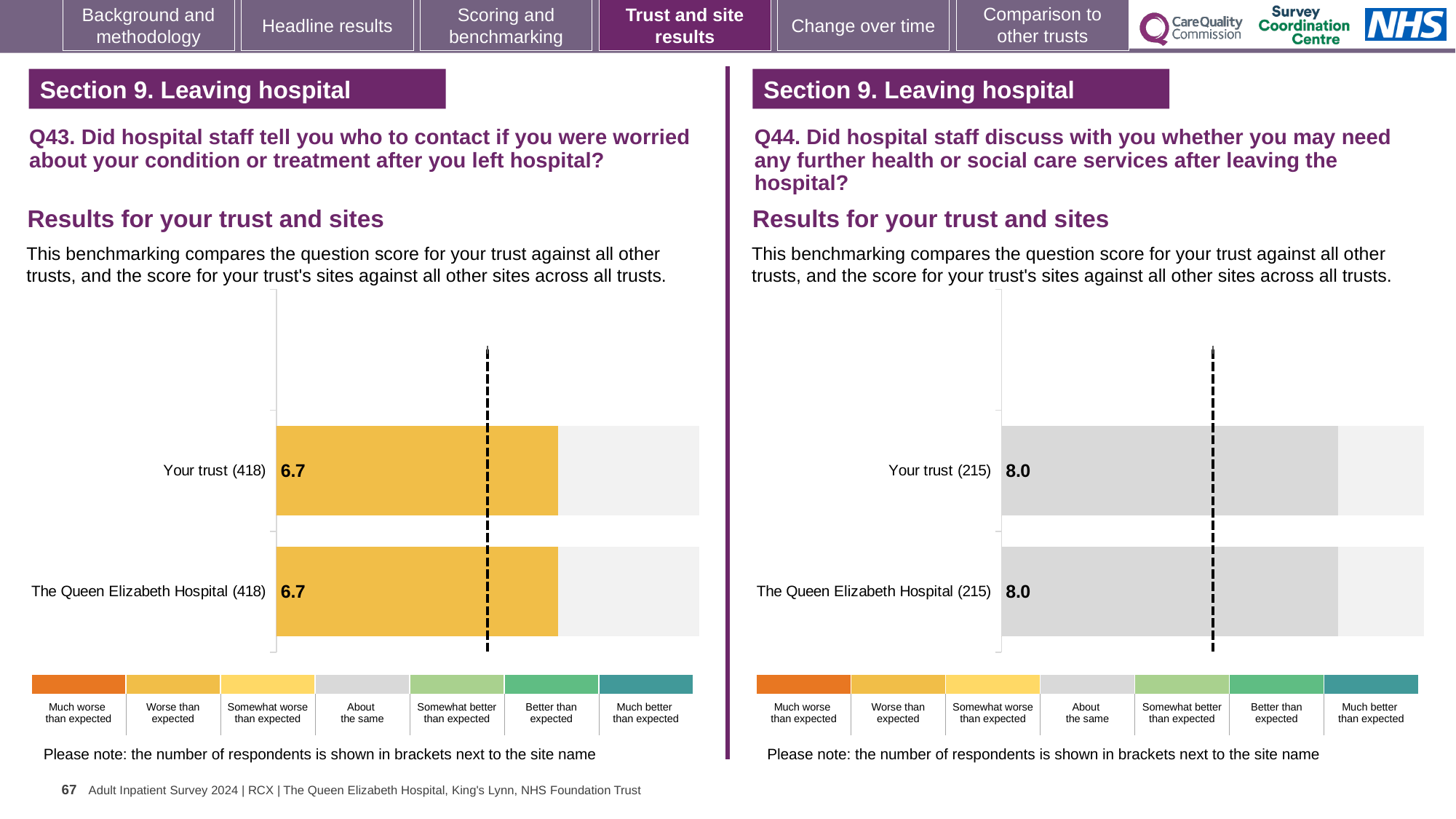
On the right chart (Q44), what is the score for The Queen Elizabeth Hospital? 8.0 What kind of chart is used on the left (Q43)? Bar chart On the left chart (Q43), how many respondents are shown in brackets for Your trust? 418 On the right chart (Q44), what is the difference between the score for Your trust and the score for The Queen Elizabeth Hospital? 0.0 On the left chart (Q43), what is the difference between the score for Your trust and the score for The Queen Elizabeth Hospital? 0.0 How many bars are plotted on the right chart (Q44)? 2 How many bars are plotted on the left chart (Q43)? 2 On the left chart (Q43), what is the score for Your trust? 6.7 On the right chart (Q44), what is the score for Your trust? 8.0 According to the colour key, which benchmark category do the bars on the right chart (Q44) fall into? About the same On the left chart (Q43), what is the score for The Queen Elizabeth Hospital? 6.7 On the right chart (Q44), how many respondents are shown in brackets for The Queen Elizabeth Hospital? 215